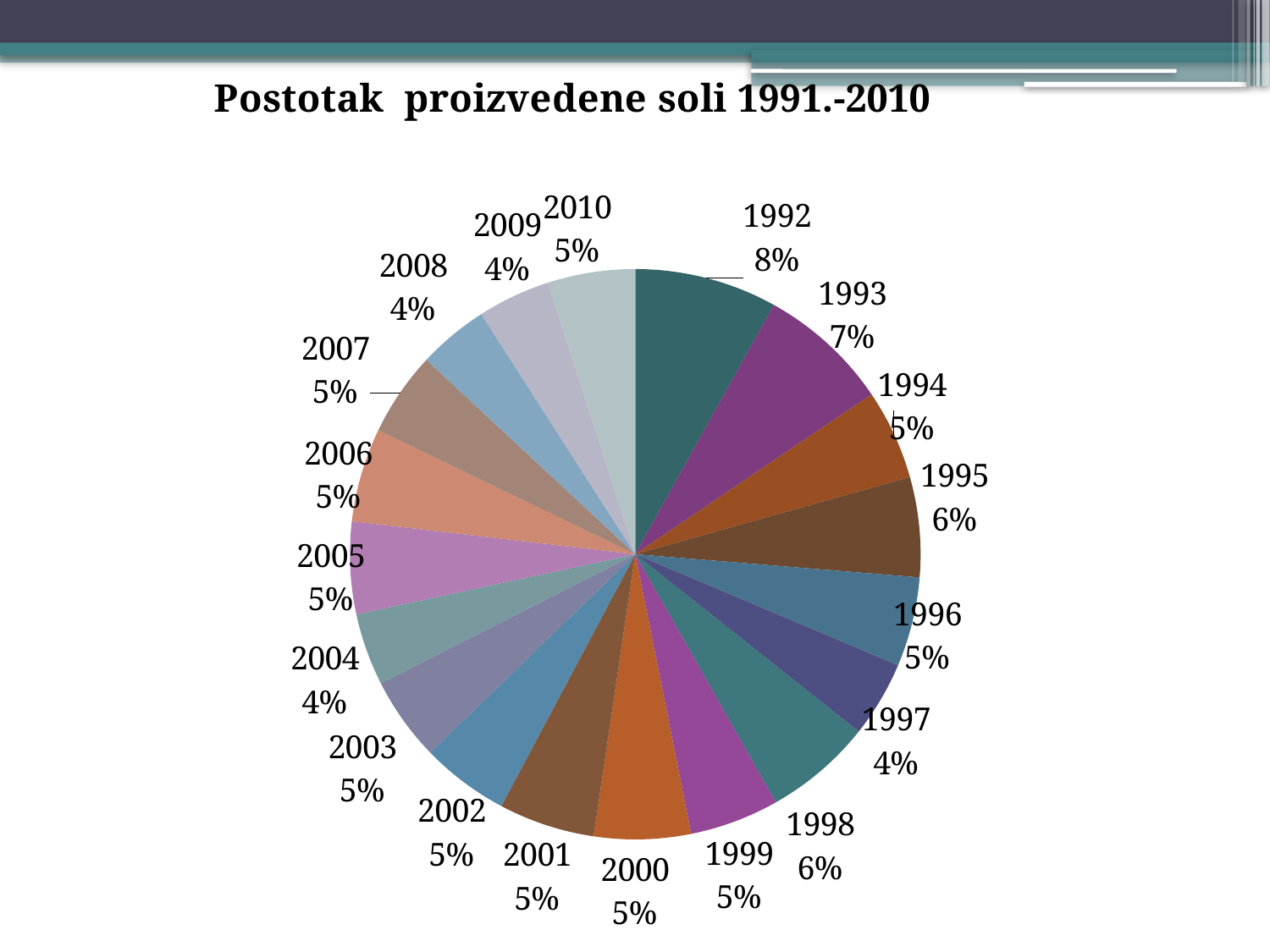
Which has a larger share, 1995 or 1996? 1995 How many slices does the pie chart have? 19 What percentage is shown for 1992? 8% What is the difference between the shares for 1992 and 1997? 4% Which year has the largest share of the pie? 1992 What is the title of the chart? Postotak proizvedene soli 1991.-2010 What percentage is shown for 2010? 5% What percentage is shown for 1998? 6% What percentage is shown for 1993? 7% What percentage is shown for 2004? 4% What is the difference between the shares for 1992 and 1993? 1% What type of chart is shown on the slide? pie chart